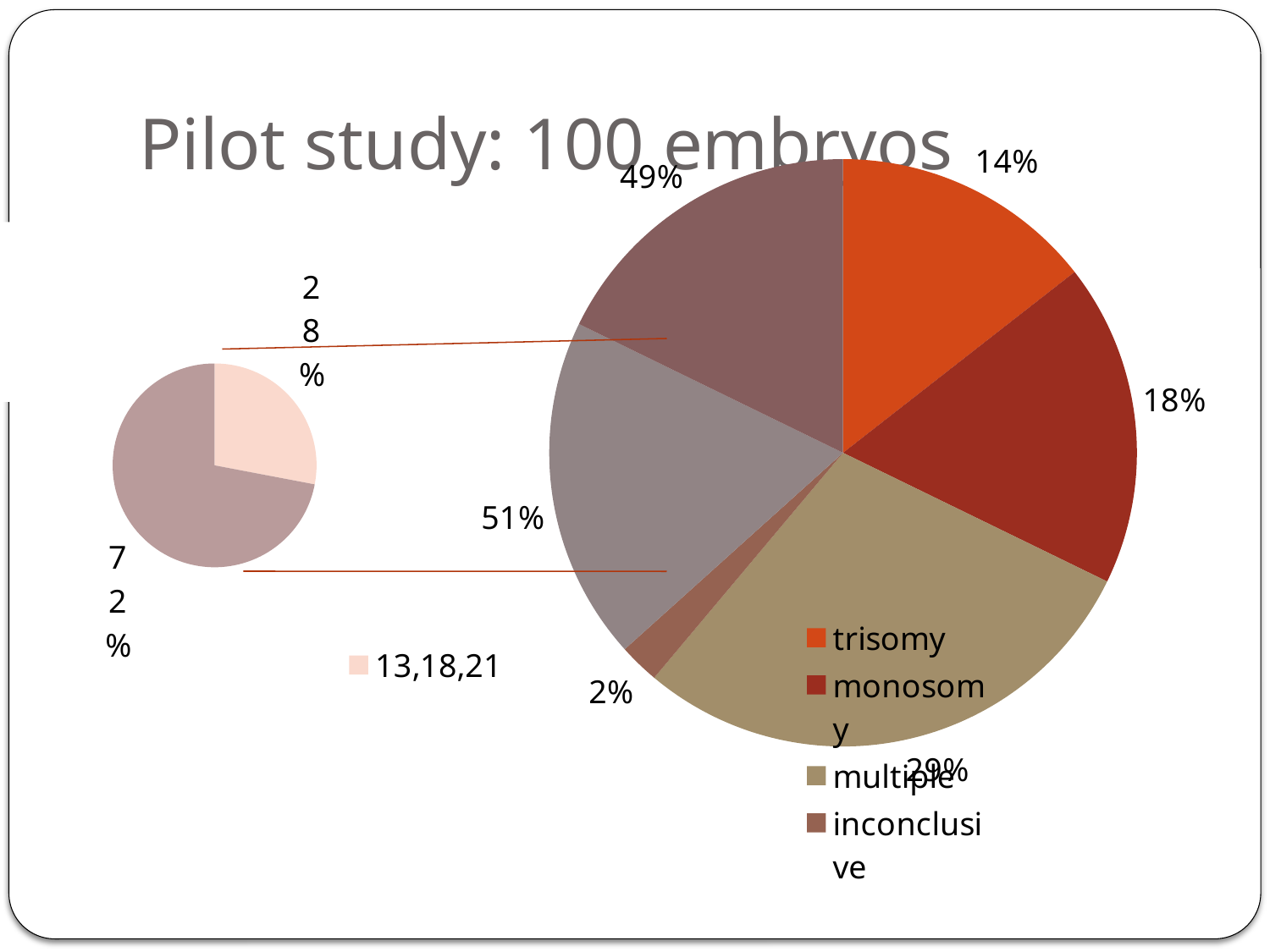
In the small pie chart on the left, what share is labelled for the slice '13,18,21'? 28% In the large pie chart, which is larger, multiple or monosomy? multiple What kind of chart is the large chart on the right of the slide? pie chart In the large pie chart, what percentage is labelled for multiple? 29% How many entries does the legend of the large pie chart list? 4 In the large pie chart, what is the difference between the monosomy and trisomy percentages? 4% In the large pie chart, what is the difference between the multiple and trisomy percentages? 15% In the large pie chart, what percentage is labelled for trisomy? 14% What is the title of the slide? Pilot study: 100 embryos In the small pie chart on the left, what percentage is labelled on the larger slice? 72% In the large pie chart, which is larger, trisomy or monosomy? monosomy In the large pie chart, what percentage is labelled for monosomy? 18%